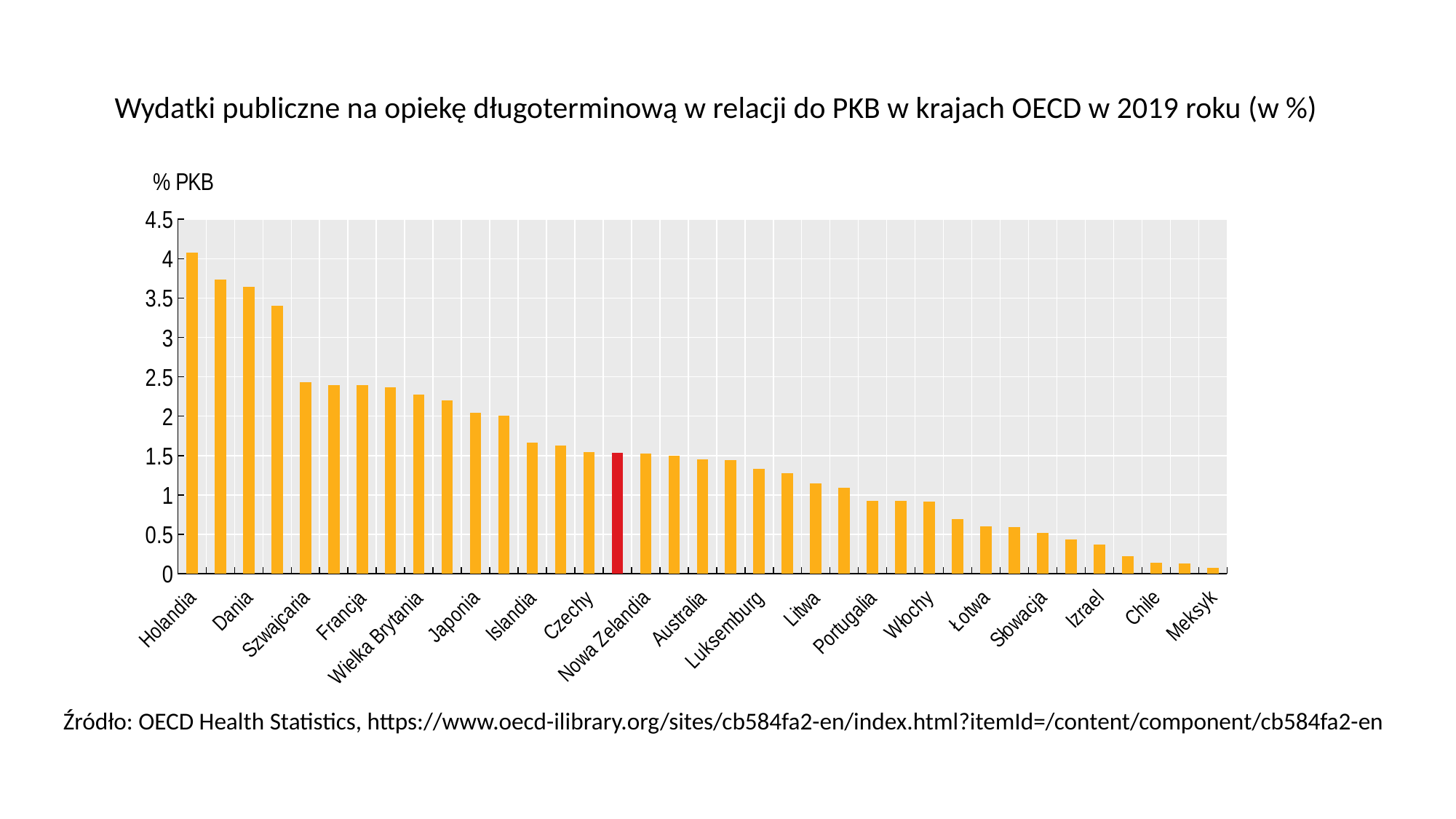
What label is shown on the vertical axis of the chart? % PKB Is the value for Francja greater or less than 2? greater Is the value for Holandia greater or less than 3.5? greater Is the value for Izrael greater or less than 0.5? less Which country has the highest public long-term care spending as a share of GDP? Holandia Do the values rise or fall moving from left to right along the x axis? fall Which has the larger value, Litwa or Portugalia? Litwa What kind of chart is shown on the slide? bar chart Which has the larger value, Holandia or Dania? Holandia Which country has the lowest value on the chart? Meksyk